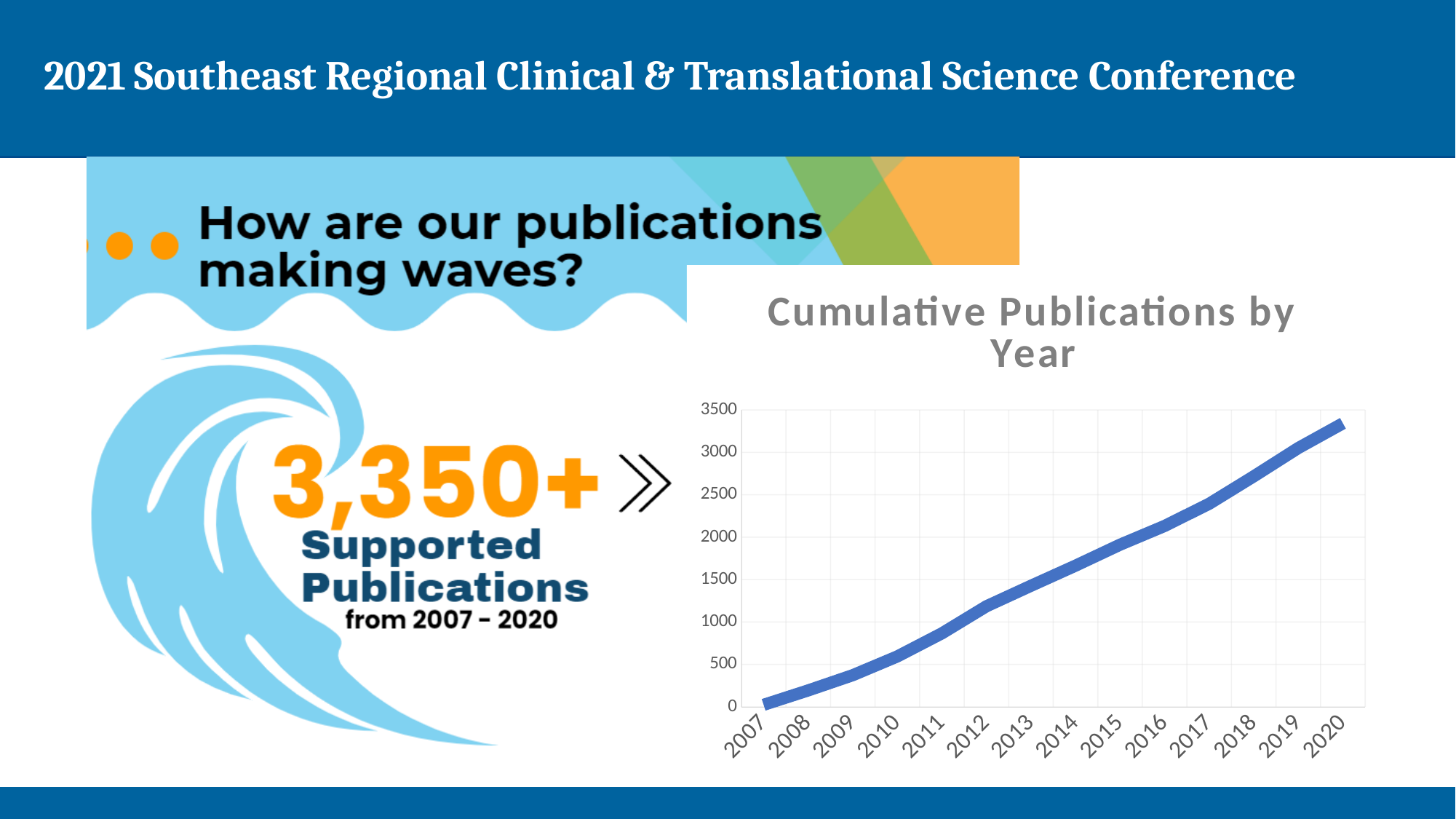
In the 'Cumulative Publications by Year' chart, which year has the lowest value? 2007 In the 'Cumulative Publications by Year' chart, which year has the highest value? 2020 What is the title of the line chart on the slide? Cumulative Publications by Year In the 'Cumulative Publications by Year' chart, is the value for 2009 greater or less than 500? less What kind of chart is 'Cumulative Publications by Year'? line chart In the 'Cumulative Publications by Year' chart, is the value for 2017 greater or less than 2500? less In the 'Cumulative Publications by Year' chart, which year has the larger value, 2012 or 2016? 2016 How many years are plotted on the x axis of the 'Cumulative Publications by Year' chart? 14 In the 'Cumulative Publications by Year' chart, do the values rise or fall from 2007 to 2020? rise In the 'Cumulative Publications by Year' chart, is the value for 2015 greater or less than 1500? greater